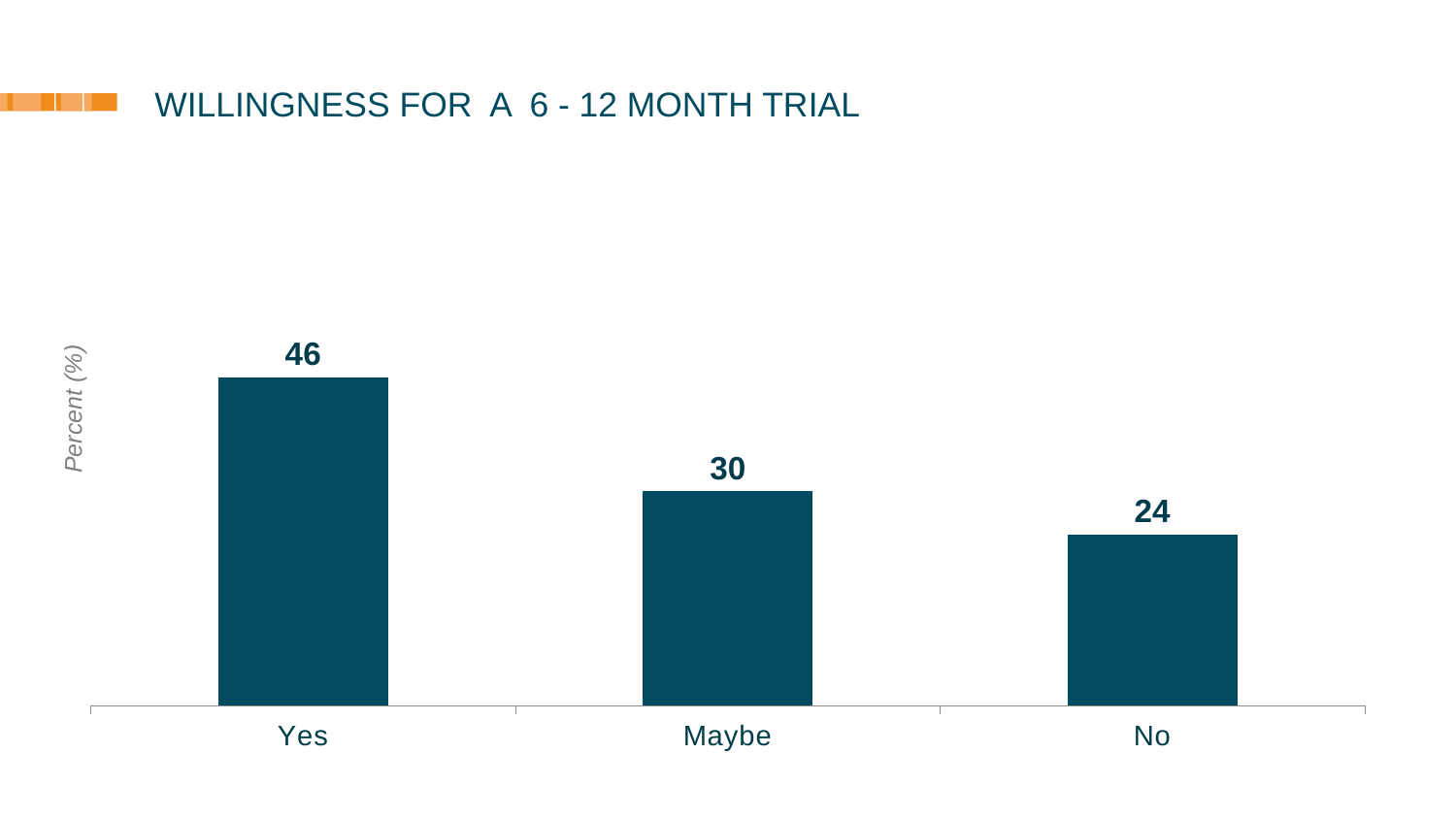
What is the label on the vertical axis? Percent (%) What is the difference between the values for Maybe and No? 6 What is the value for No? 24 How many categories are shown on the x axis? 3 What is the difference between the values for Yes and No? 22 Which category has the lowest value? No Which is larger, the value for Maybe or the value for No? Maybe What kind of chart is this? bar chart What is the value for Maybe? 30 What is the value for Yes? 46 Do the values rise or fall from Yes to No along the x axis? fall Which category has the highest value? Yes